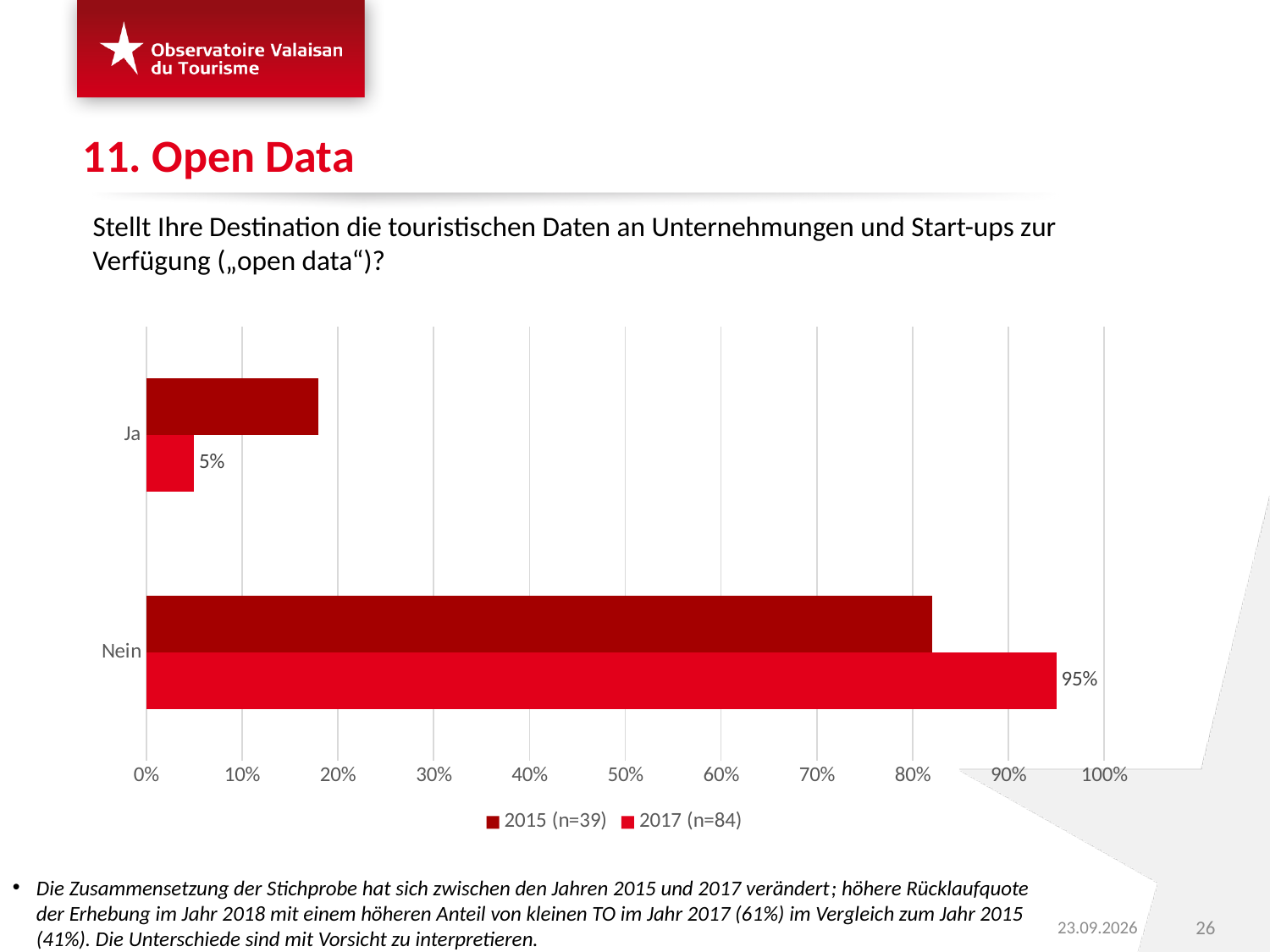
What kind of chart is shown on the slide? Bar chart For "Nein", which series has the larger value, 2015 (n=39) or 2017 (n=84)? 2017 (n=84) What is the value for "Ja" in the 2017 (n=84) series? 5% For "Ja", which series has the larger value, 2015 (n=39) or 2017 (n=84)? 2015 (n=39) What is the difference between the 2017 (n=84) values for "Nein" and "Ja"? 90 percentage points Is the 2015 (n=39) value for "Ja" greater or less than 10%? greater What is the value for "Nein" in the 2017 (n=84) series? 95% How many categories are shown on the chart? 2 Is the 2015 (n=39) value for "Nein" greater or less than 70%? greater Is the 2015 (n=39) value for "Nein" greater or less than 90%? less How many series does the legend list? 2 Which category has the highest value in the 2017 (n=84) series? Nein